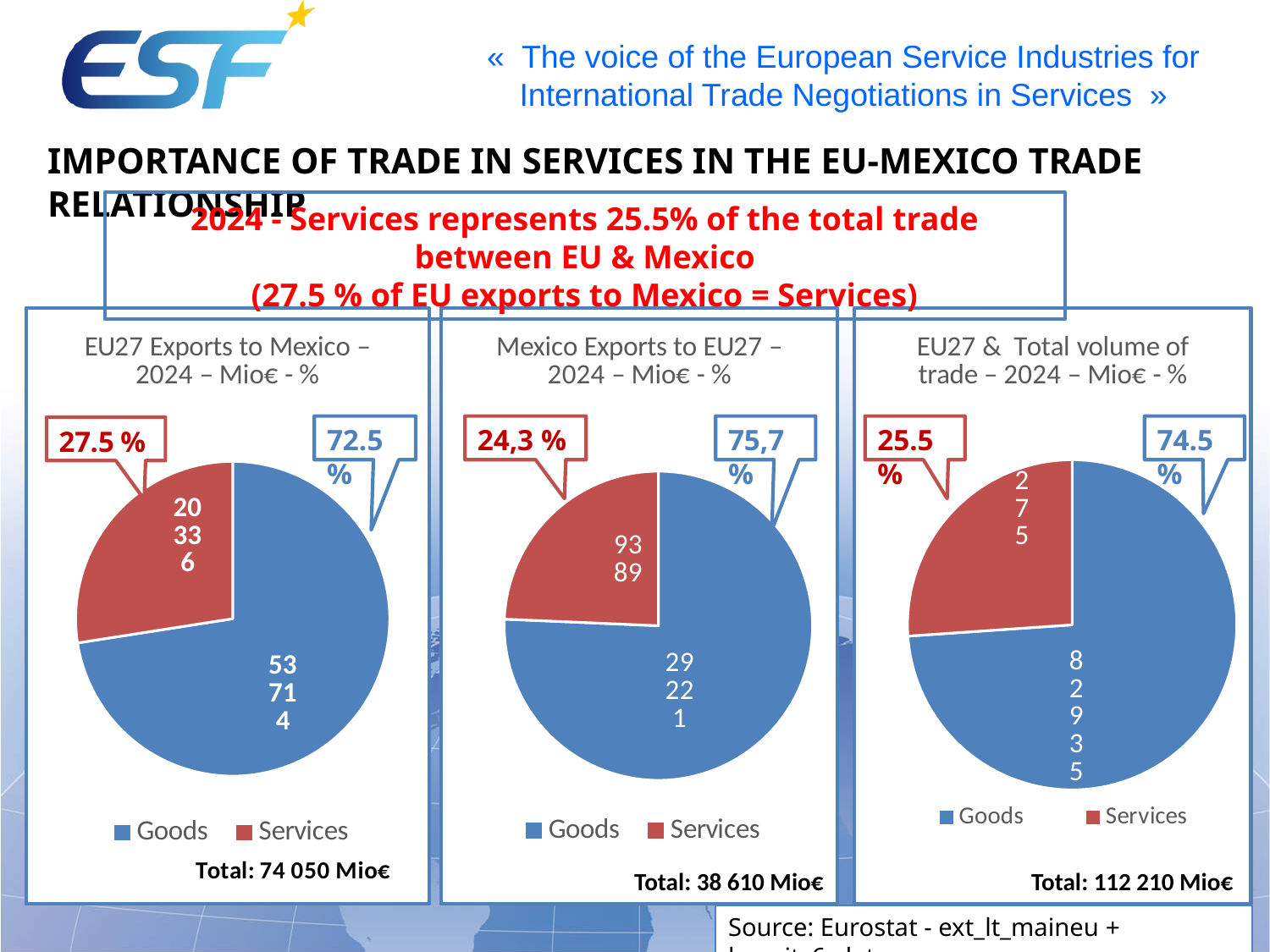
In the EU27 & Total volume of trade – 2024 chart, what percentage share do Services have? 25.5 % What is the total shown below the EU27 & Total volume of trade – 2024 chart? 112 210 Mio€ How many categories does the legend of the EU27 Exports to Mexico – 2024 chart list? 2 What is the total shown below the EU27 Exports to Mexico – 2024 chart? 74 050 Mio€ In the EU27 Exports to Mexico – 2024 chart, what percentage share do Services have? 27.5 % In the EU27 & Total volume of trade – 2024 chart, what percentage share do Goods have? 74.5 % In the Mexico Exports to EU27 – 2024 chart, which category has the larger slice, Goods or Services? Goods What is the total shown below the Mexico Exports to EU27 – 2024 chart? 38 610 Mio€ What kind of chart is used on this slide for the EU27 Exports to Mexico data? pie chart